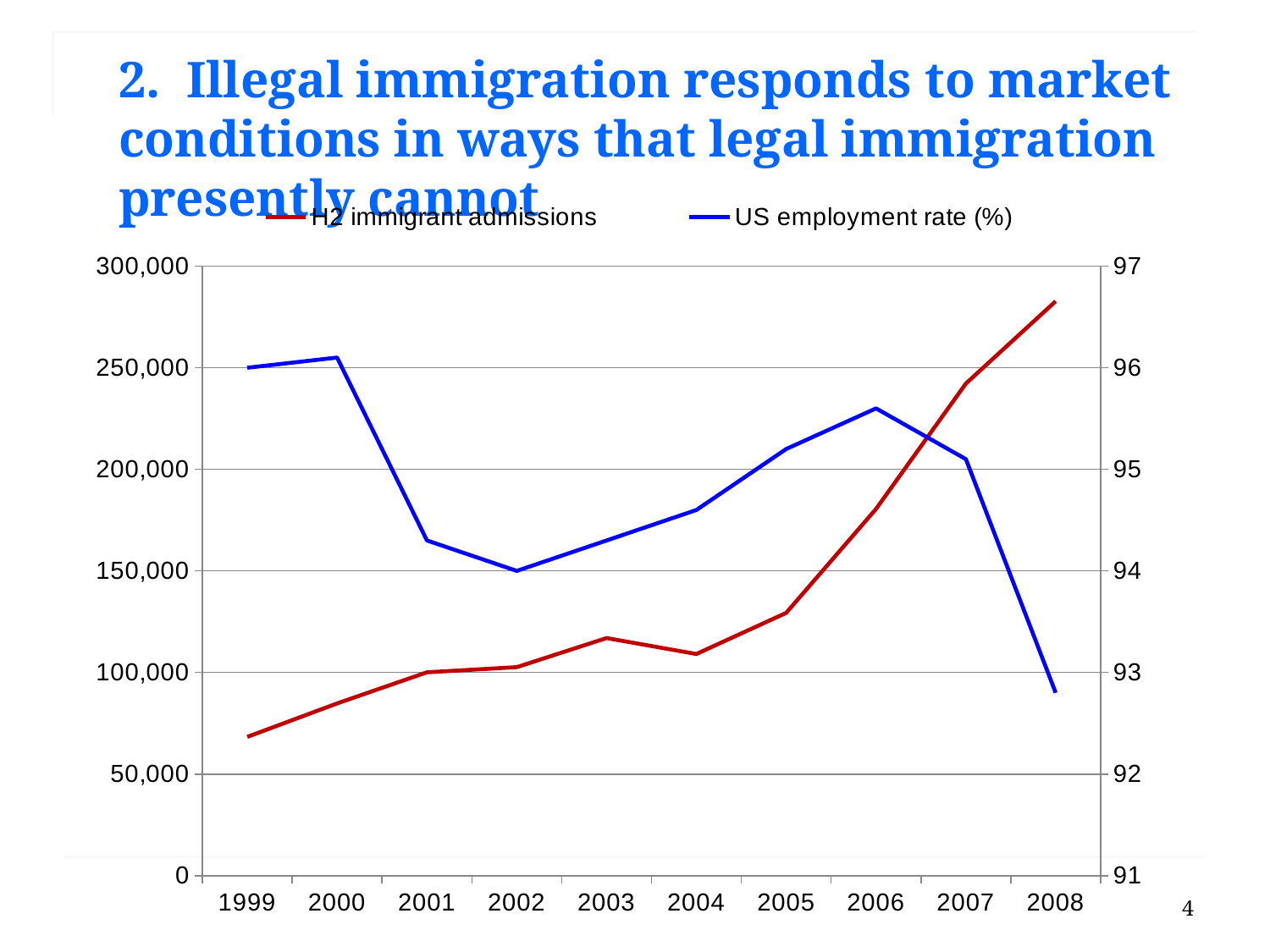
Is the US employment rate (%) in 2006 greater or less than 95? greater How many series does the legend list? 2 Which year has more H2 immigrant admissions, 2003 or 2004? 2003 In which year are H2 immigrant admissions lowest? 1999 What kind of chart is shown on the slide? Line chart In which year is the US employment rate (%) lowest? 2008 Is the value for H2 immigrant admissions in 2005 greater or less than 150,000? less Is the value for H2 immigrant admissions in 2007 greater or less than 200,000? greater How many years are plotted along the x axis? 10 Do H2 immigrant admissions rise or fall from 2004 to 2008? Rise In which year are H2 immigrant admissions highest? 2008